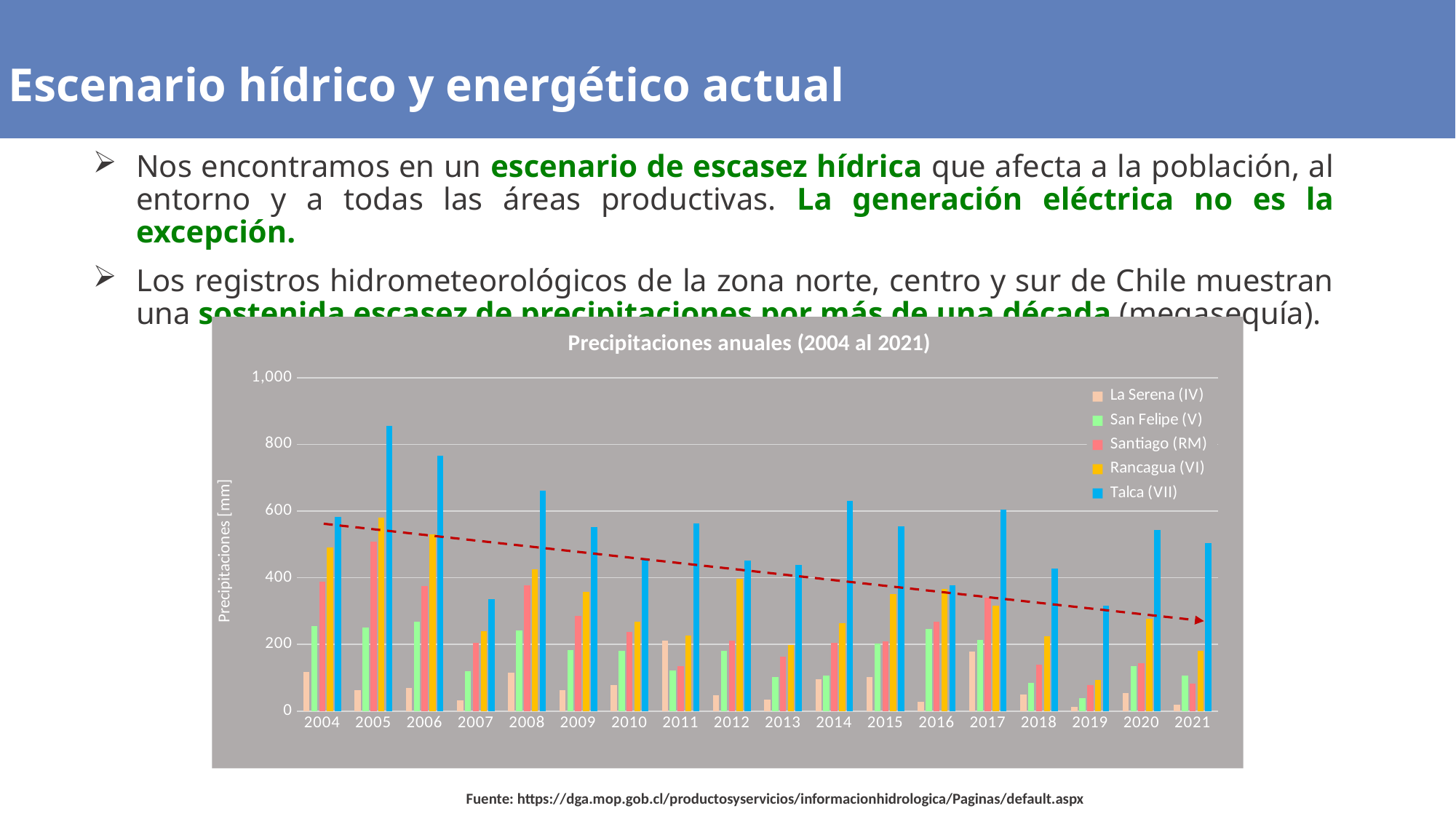
Is the value for Rancagua (VI) in 2005 greater or less than 400? greater How many years are shown on the x axis of the chart? 18 According to the dashed trend line, do the precipitation values rise or fall from 2004 to 2021? fall What is the title of the chart? Precipitaciones anuales (2004 al 2021) Which is larger, the value for Talca (VII) in 2008 or in 2009? 2008 Is the value for Talca (VII) in 2005 greater or less than 800? greater In which year does Talca (VII) reach its highest value? 2005 What kind of chart is shown on the slide? bar chart What is the label of the y axis of the chart? Precipitaciones [mm] How many series does the legend of the chart list? 5 Which series has the highest value in 2005? Talca (VII) Is the value for Talca (VII) in 2007 greater or less than 400? less